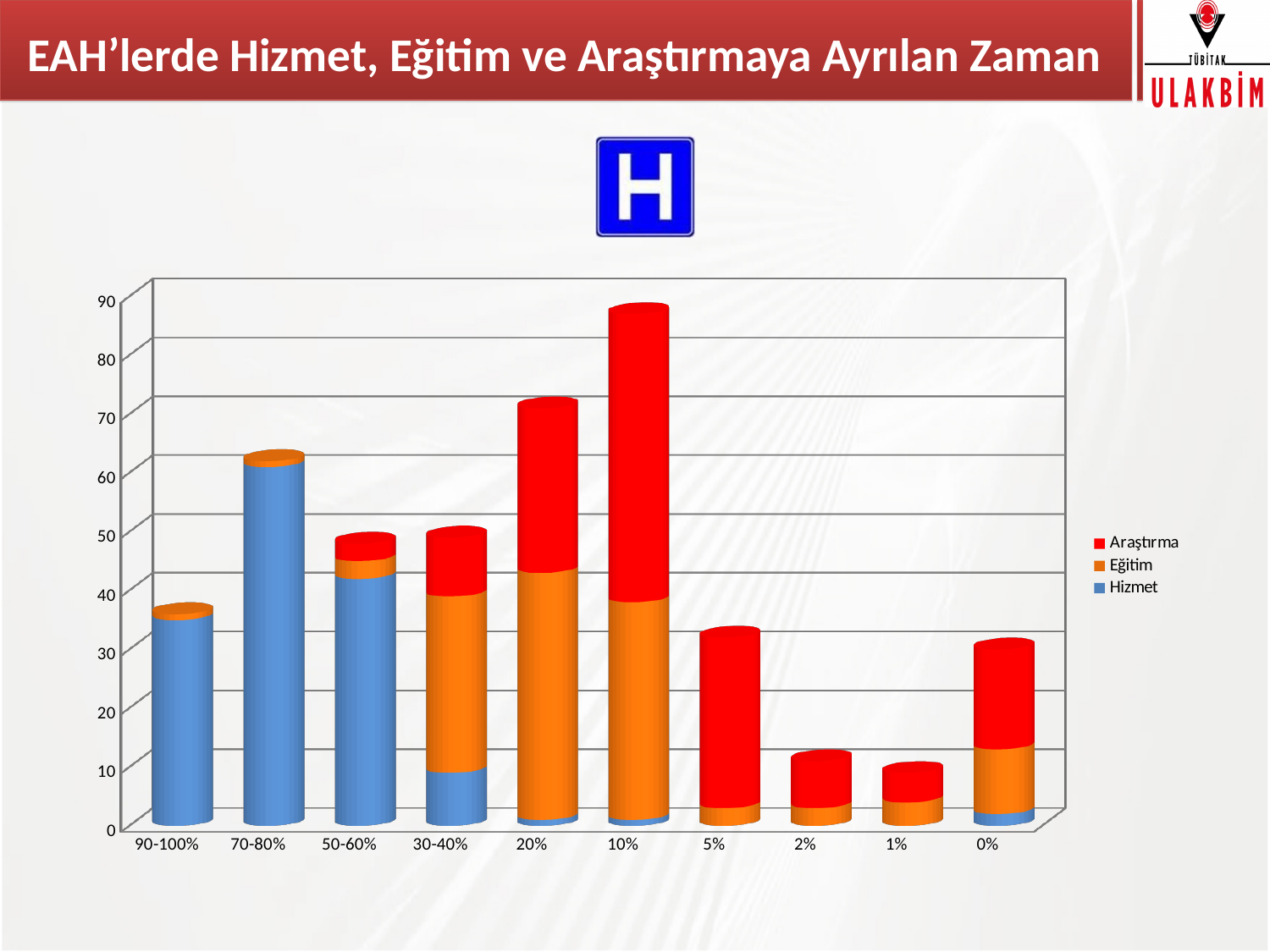
Is the total of the stacked bar for 1% greater or less than 20? less What kind of chart is shown on the slide? Stacked bar chart Is the total of the stacked bar for 10% greater or less than 80? greater How many categories are shown on the x axis of the chart? 10 Which category has the largest Hizmet segment? 70-80% Which stacked bar is taller, 5% or 2%? 5% Is the total of the stacked bar for 90-100% greater or less than 40? less Which stacked bar is taller, 70-80% or 90-100%? 70-80% Which category has the tallest stacked bar? 10% How many series does the chart's legend list? 3 Which series is shown in red in the chart's legend? Araştırma